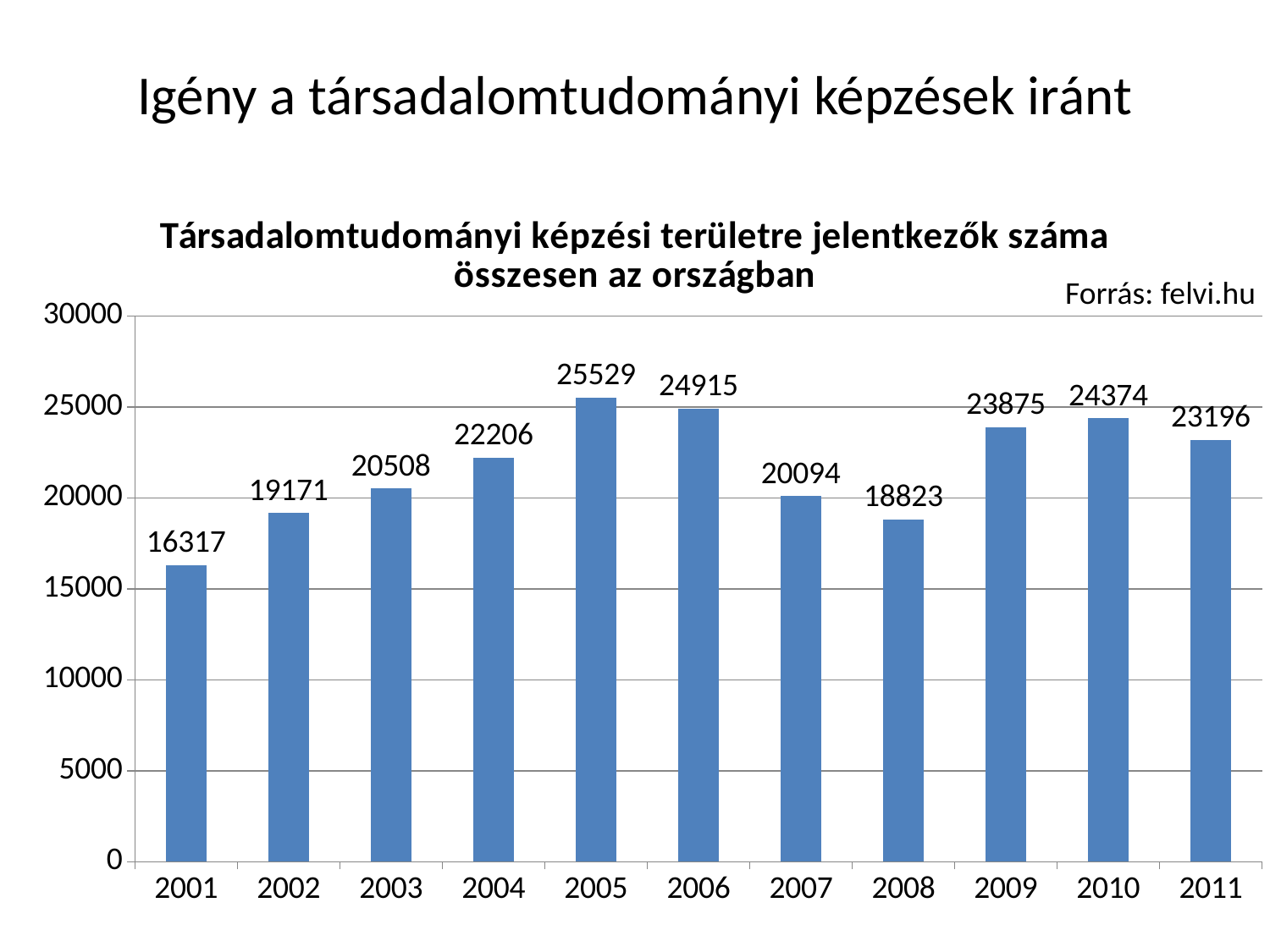
What is the difference between the values for 2005 and 2006? 614 Is the value for 2004 greater or less than 20000? greater Do the values rise or fall from 2001 to 2005? rise What is the value for 2001? 16317 Which year has the lowest value? 2001 What is the difference between the values for 2011 and 2001? 6879 What is the value for 2008? 18823 What is the value for 2005? 25529 How many years are shown on the x axis? 11 What kind of chart is shown on the slide? bar chart Which is larger, the value for 2009 or the value for 2010? 2010 Which year has the highest value? 2005